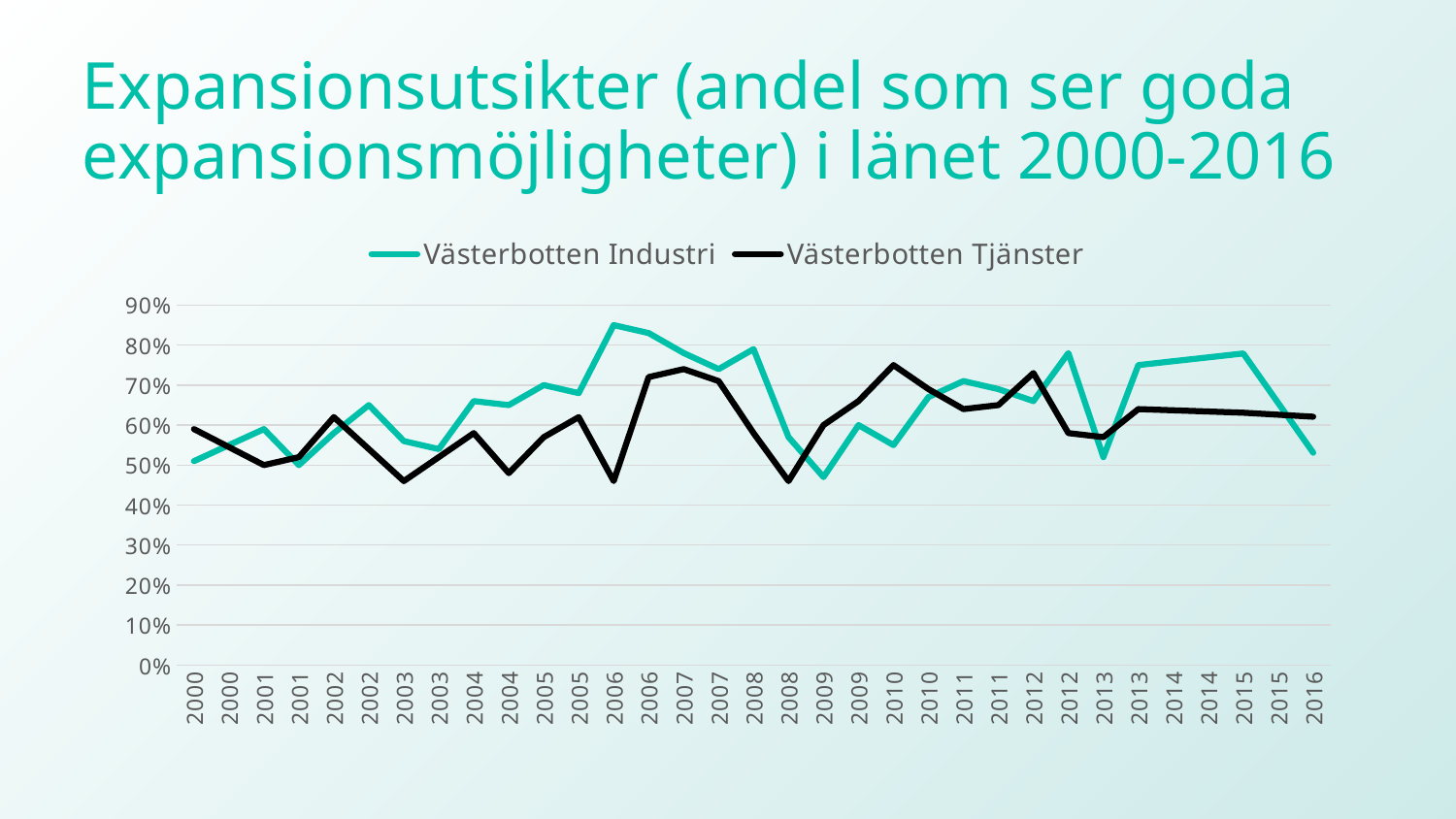
Is the value for Västerbotten Tjänster at the first 2010 point greater or less than 70%? greater At the first 2010 point, which series has the higher value, Västerbotten Industri or Västerbotten Tjänster? Västerbotten Tjänster What kind of chart is shown on the slide? line chart Which colour is the Västerbotten Tjänster line drawn in? black Is the value for Västerbotten Tjänster at the first 2003 point greater or less than 50%? less At which x-axis point does the Västerbotten Industri line reach its highest value? 2006 (first point) Is the value for Västerbotten Industri at the first 2006 point greater or less than 80%? greater How many series does the legend list? 2 At the first 2006 point, which series has the higher value, Västerbotten Industri or Västerbotten Tjänster? Västerbotten Industri What is the highest value shown on the y axis? 90% What are the two series named in the legend? Västerbotten Industri and Västerbotten Tjänster